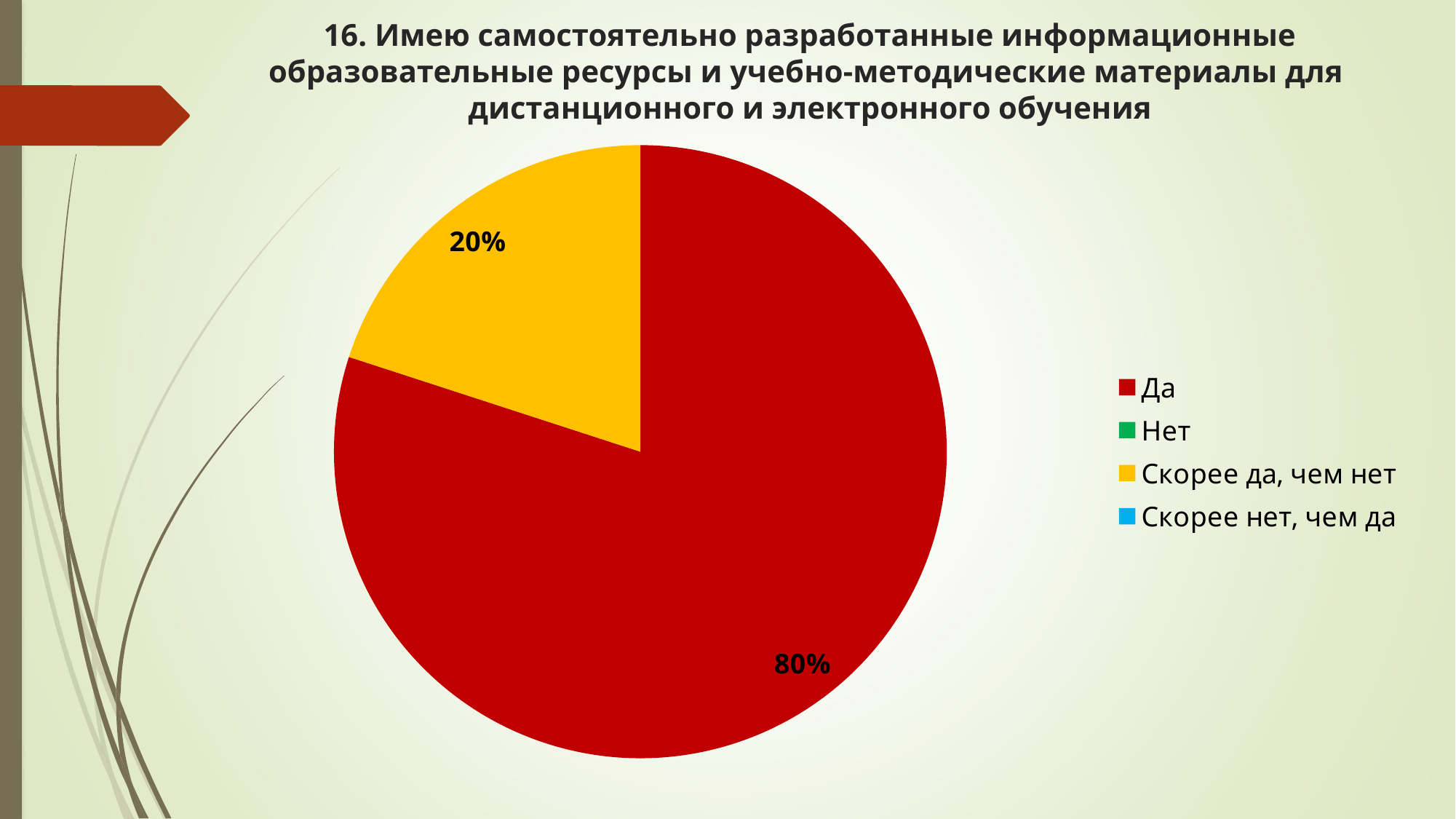
Which category has the largest slice of the pie? Да What share of the pie does "Скорее да, чем нет" have? 20% Is the share for "Да" greater or less than 50%? greater What colour is the slice for "Скорее да, чем нет"? yellow What is the difference between the shares of "Да" and "Скорее да, чем нет"? 60% How many categories does the legend list? 4 What share of the pie does "Да" have? 80% Which of the two visible slices is larger, "Да" or "Скорее да, чем нет"? Да What kind of chart is shown on the slide? pie chart How many slices are visible in the pie? 2 What colour is the slice for "Да"? red